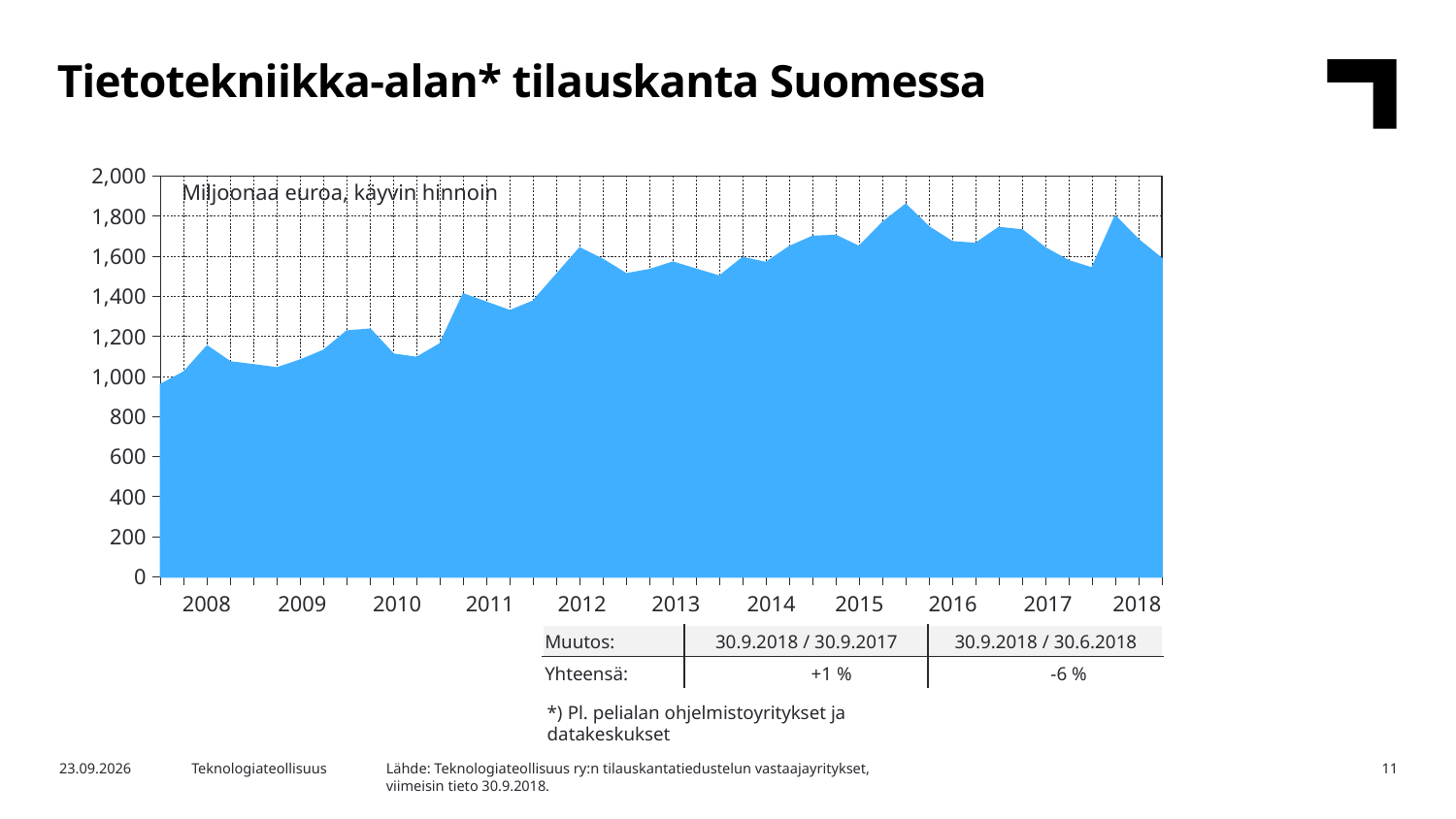
How many years are labeled on the x axis of the chart? 11 According to the table below the chart, what is the total change (Yhteensä) for 30.9.2018 / 30.6.2018? -6 % What unit is the chart's data expressed in, according to the label inside the plot area? Miljoonaa euroa, käyvin hinnoin Overall, does the order backlog rise or fall from 2008 to 2018? rise Is the value at 2018 greater or less than 1,400? greater Is the value at 2012 greater or less than 1,400? greater Is the value at 2009 greater or less than 1,400? less Around which labeled year is the series at its lowest value? 2008 Around which labeled year does the series reach its highest value? 2015 What kind of chart is shown on the slide? area chart What is the title of the chart on the slide? Tietotekniikka-alan* tilauskanta Suomessa